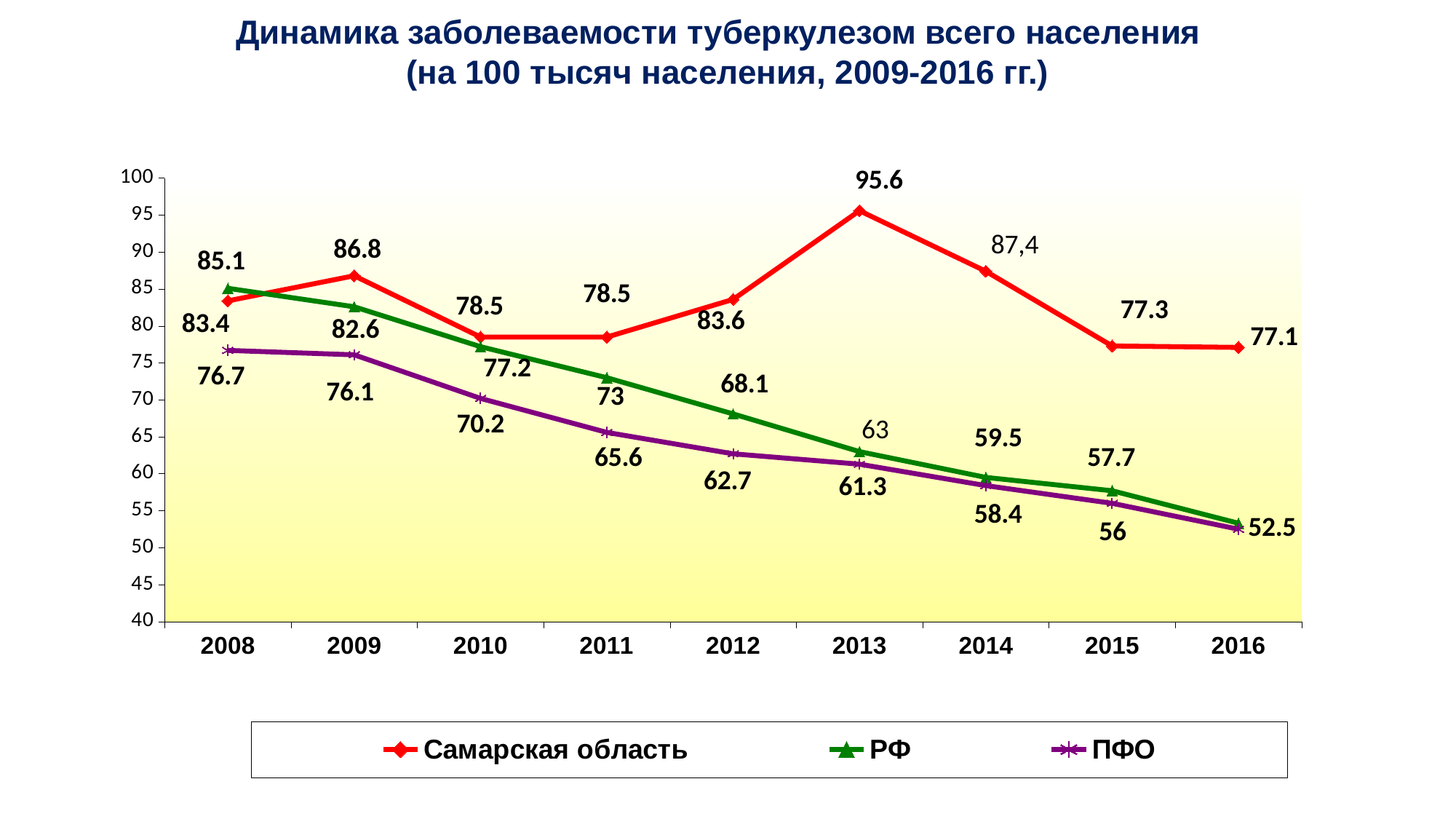
In which year does Самарская область reach its highest value? 2013 What is the value for Самарская область in 2014? 87,4 What is the difference between the РФ values in 2008 and 2013? 22.1 How many years are plotted along the x axis? 9 What kind of chart is shown on the slide? line chart What is the value for ПФО in 2015? 56 What is the value for Самарская область in 2013? 95.6 What is the value for РФ in 2011? 73 What is the difference between the Самарская область values in 2013 and 2015? 18.3 Does the РФ series rise or fall from 2008 to 2016? fall How many series does the legend list? 3 In 2012, which is larger: the value for РФ or the value for ПФО? РФ